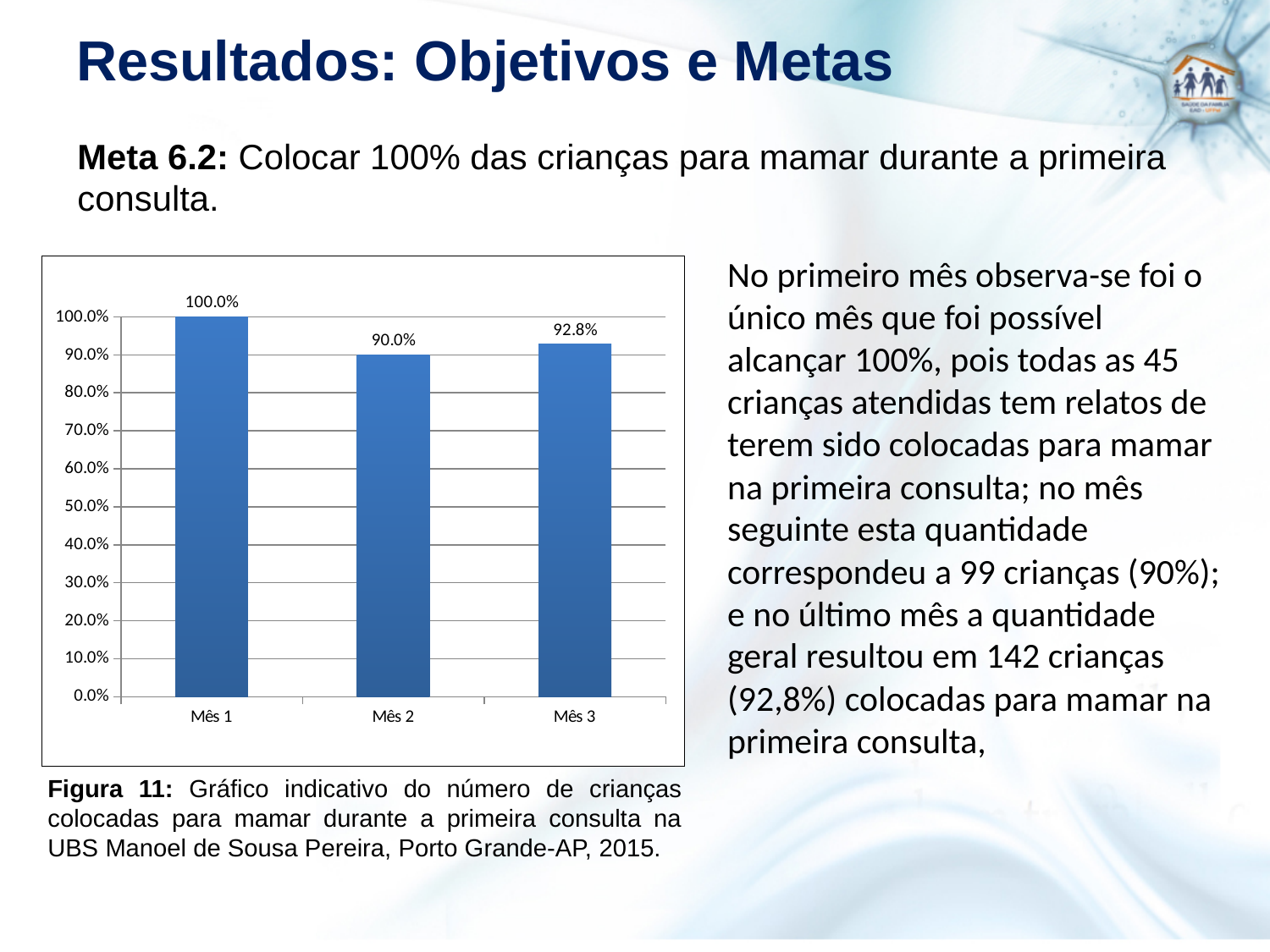
What is the value for Mês 2? 90.0% Which month has the lowest value? Mês 2 What is the figure number given in the caption below the chart? Figura 11 What is the value for Mês 3? 92.8% How many months are shown on the x axis? 3 What is the value for Mês 1? 100.0% Which month has the highest value? Mês 1 What is the difference between the values for Mês 1 and Mês 2? 10.0% Is the value for Mês 3 greater or less than 90.0%? greater What kind of chart is shown? bar chart What is the difference between the values for Mês 3 and Mês 2? 2.8% Which is larger, the value for Mês 2 or Mês 3? Mês 3